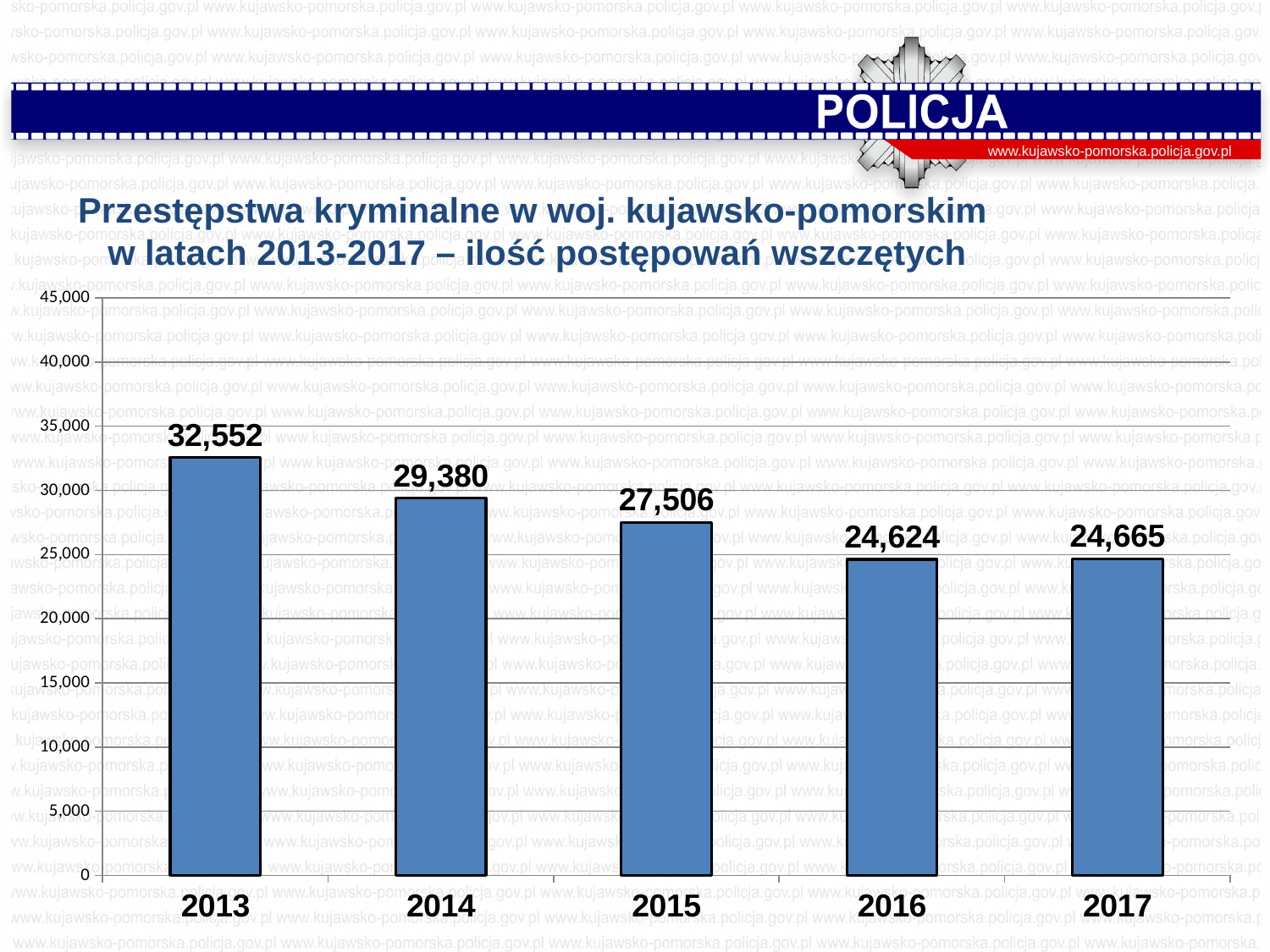
Which year has the highest value? 2013 How many years are shown on the x axis? 5 Is the value for 2015 greater or less than 30,000? less What kind of chart is shown on the slide? bar chart What is the value for 2013? 32,552 What is the value for 2015? 27,506 What is the difference between the values for 2017 and 2016? 41 What is the difference between the values for 2013 and 2014? 3,172 Which is larger, the value for 2014 or the value for 2015? 2014 What is the value for 2017? 24,665 Do the values generally rise or fall from 2013 to 2016? fall Which year has the lowest value? 2016